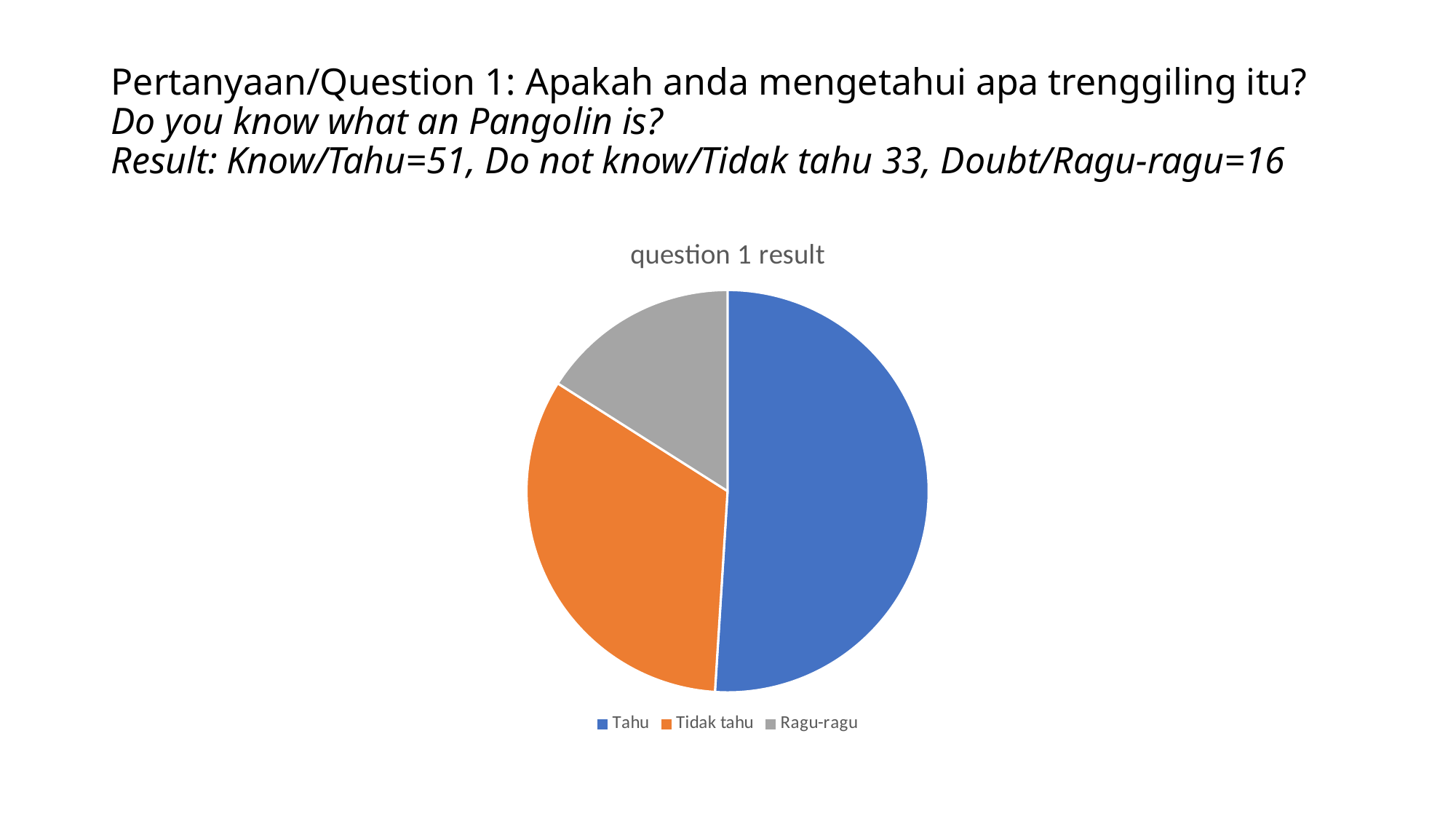
What is the title of the chart? question 1 result Which is larger, the slice for Tidak tahu or the slice for Ragu-ragu? Tidak tahu Which category has the smallest slice of the pie? Ragu-ragu What is the difference between the values for Tahu and Tidak tahu? 18 What is the value for Tahu? 51 What colour is the Tidak tahu slice? orange What is the value for Ragu-ragu? 16 How many entries does the legend list? 3 How many slices does the pie chart have? 3 What kind of chart is shown on the slide? pie chart What is the value for Tidak tahu? 33 Which category has the largest slice of the pie? Tahu